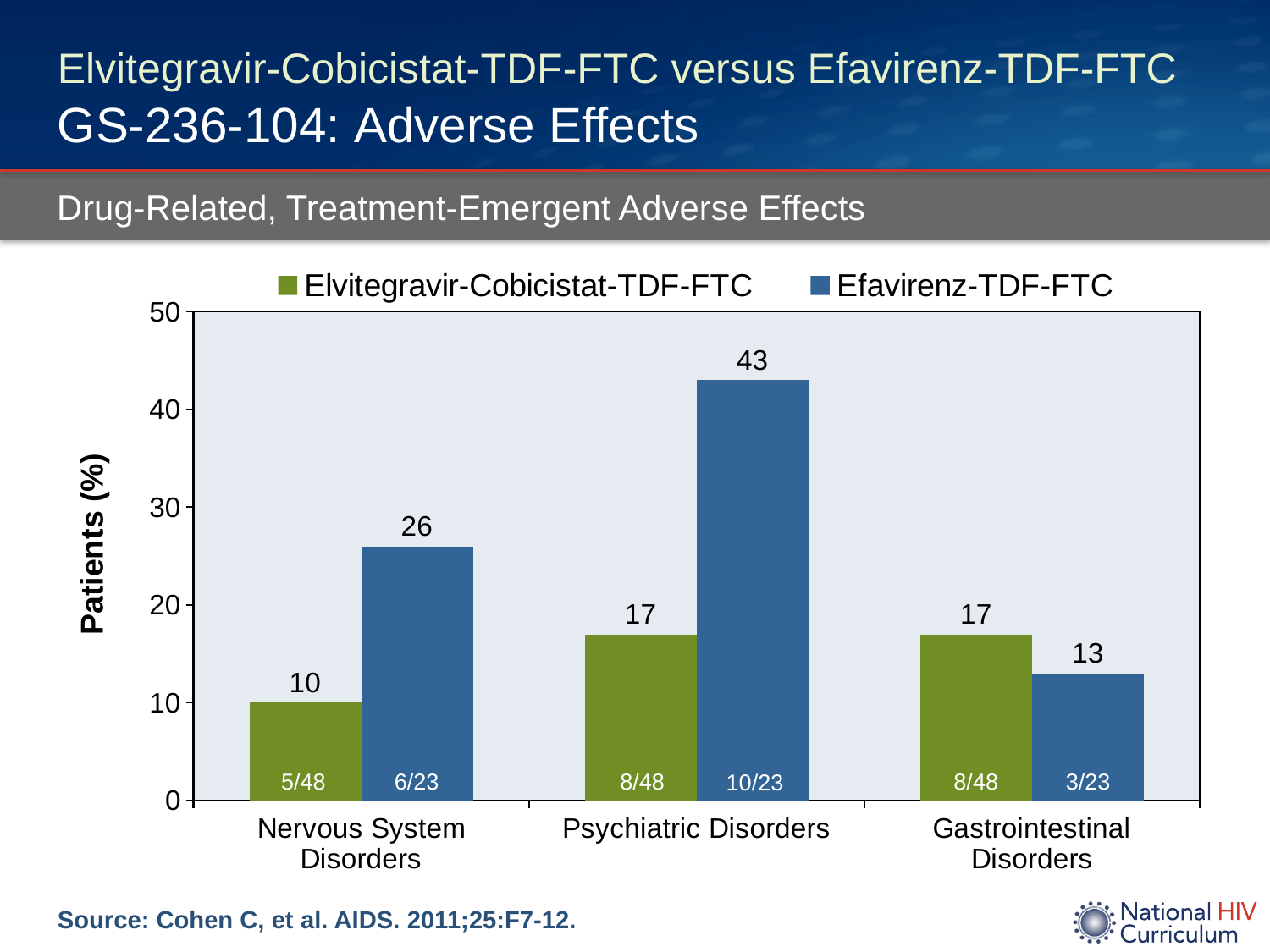
Which adverse effect category has the lowest value for Elvitegravir-Cobicistat-TDF-FTC? Nervous System Disorders How many series does the legend list? 2 How many adverse effect categories are shown on the x axis? 3 What percentage of patients on Efavirenz-TDF-FTC had Gastrointestinal Disorders? 13 Which adverse effect category has the highest value for Efavirenz-TDF-FTC? Psychiatric Disorders What fraction of patients is shown inside the Efavirenz-TDF-FTC bar for Nervous System Disorders? 6/23 What percentage of patients on Elvitegravir-Cobicistat-TDF-FTC had Nervous System Disorders? 10 What percentage of patients on Efavirenz-TDF-FTC had Psychiatric Disorders? 43 For Gastrointestinal Disorders, which treatment has the higher percentage of patients? Elvitegravir-Cobicistat-TDF-FTC What kind of chart is shown on the slide? Bar chart What is the difference in percentage points between Efavirenz-TDF-FTC and Elvitegravir-Cobicistat-TDF-FTC for Psychiatric Disorders? 26 Is the value for Efavirenz-TDF-FTC in Nervous System Disorders greater or less than 20? greater